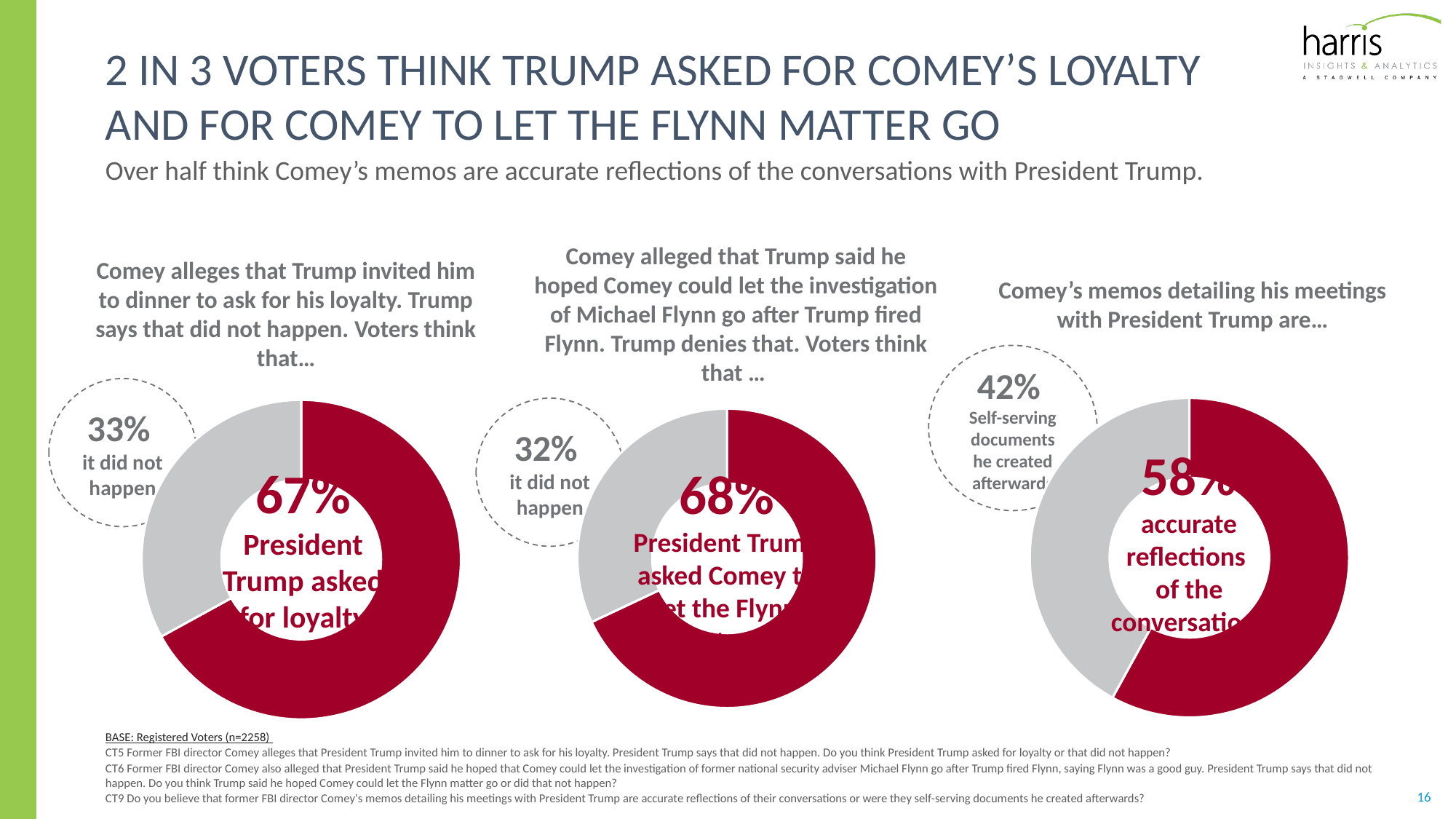
In the middle chart (Comey alleged that Trump said he hoped Comey could let the investigation of Michael Flynn go), which response is the largest? President Trump asked Comey to let the Flynn matter go In the right chart (Comey's memos detailing his meetings with President Trump are...), which response has the larger share: accurate reflections or self-serving documents? accurate reflections In the right chart (Comey's memos detailing his meetings with President Trump are...), what is the difference in percentage points between the accurate reflections share and the self-serving documents share? 16 In the left chart (Comey alleges that Trump invited him to dinner to ask for his loyalty), what share of voters think President Trump asked for loyalty? 67% How many donut charts are shown on the slide? 3 In the left chart (Comey alleges that Trump invited him to dinner to ask for his loyalty), what share of voters think it did not happen? 33% In the middle chart (Comey alleged that Trump said he hoped Comey could let the investigation of Michael Flynn go), what share of voters think it did not happen? 32% In the left chart (Comey alleges that Trump invited him to dinner to ask for his loyalty), what is the difference in percentage points between those who think Trump asked for loyalty and those who think it did not happen? 34 What kind of chart is used on this slide to show the voter responses? Donut (pie) chart In the middle chart (Comey alleged that Trump said he hoped Comey could let the investigation of Michael Flynn go), what share of voters think President Trump asked Comey to let the Flynn matter go? 68% In the right chart (Comey's memos detailing his meetings with President Trump are...), what share of voters think the memos are accurate reflections of the conversations? 58% In the right chart (Comey's memos detailing his meetings with President Trump are...), what share of voters think the memos are self-serving documents he created afterward? 42%